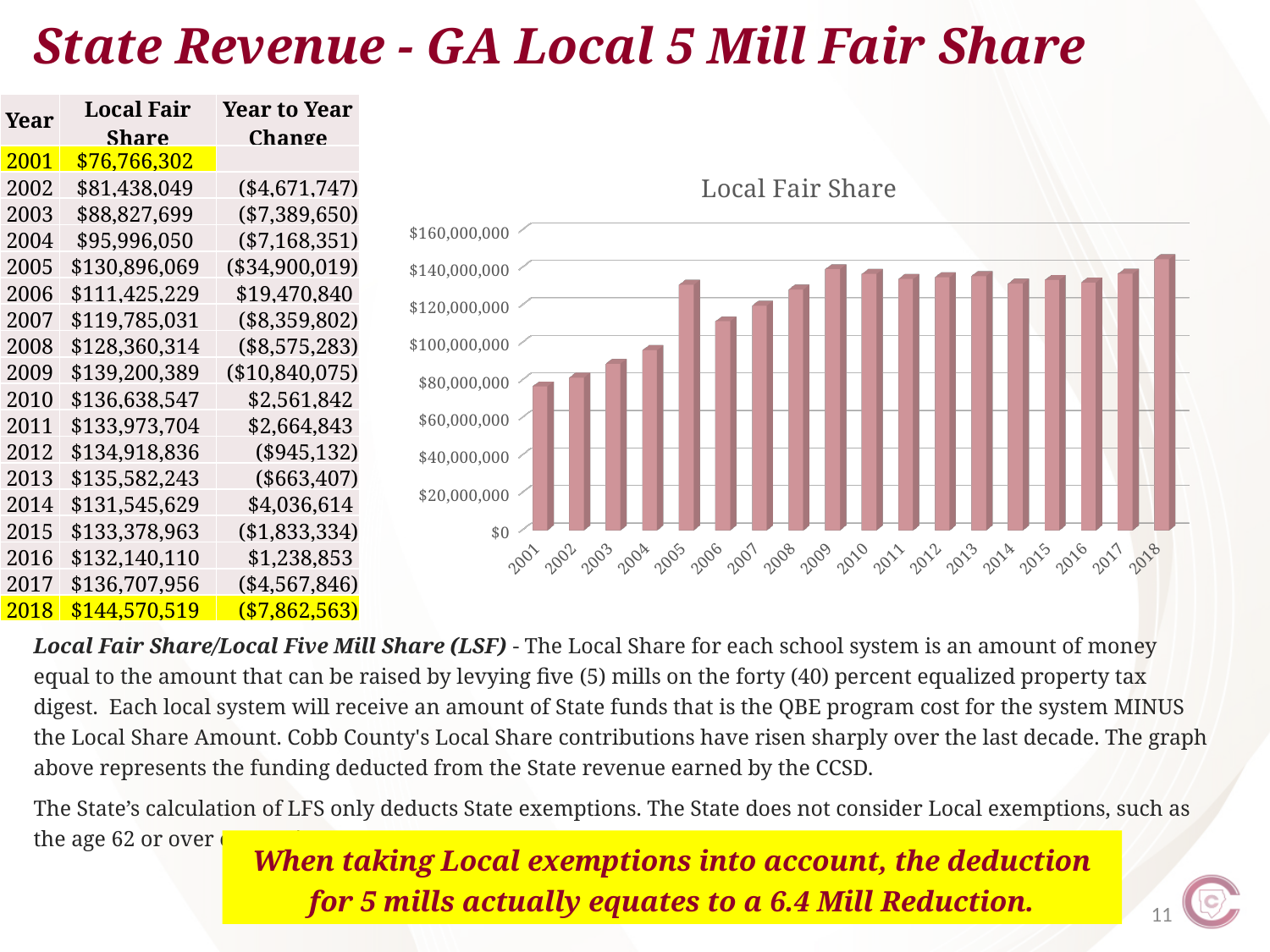
Which year has the highest Local Fair Share bar? 2018 What is the title of the chart? Local Fair Share Which year has the lowest Local Fair Share bar? 2001 Is the Local Fair Share value for 2006 greater or less than $120,000,000? less How many years are plotted on the chart's x axis? 18 Is the Local Fair Share value for 2005 greater or less than $120,000,000? greater Which year has the larger Local Fair Share bar, 2005 or 2006? 2005 According to the table on the slide, what is the Local Fair Share for 2018? $144,570,519 Using the values in the table, what is the difference between the Local Fair Share for 2018 and for 2001? $67,804,217 Do the Local Fair Share values rise or fall from 2001 to 2005? Rise What kind of chart is shown on the slide? Bar chart Is the Local Fair Share value for 2003 greater or less than $100,000,000? less